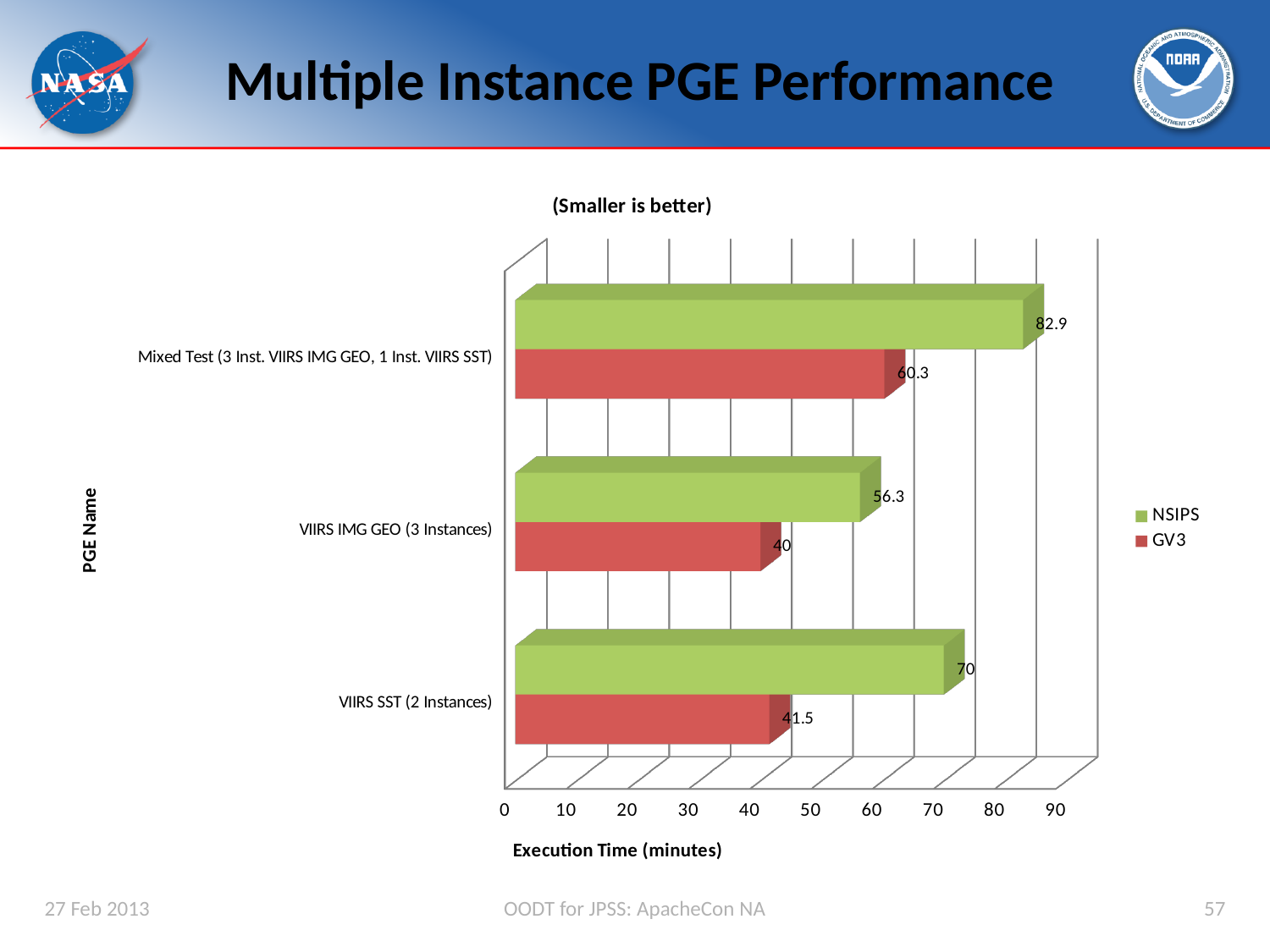
Which is larger for the Mixed Test: the NSIPS execution time or the GV3 execution time? NSIPS What is the GV3 execution time for VIIRS IMG GEO (3 Instances)? 40 Is the GV3 execution time for the Mixed Test greater or less than 50? greater How many PGEs are shown on the chart? 3 How many series does the legend list? 2 What is the NSIPS execution time for the Mixed Test (3 Inst. VIIRS IMG GEO, 1 Inst. VIIRS SST)? 82.9 What kind of chart is shown on the slide? Bar chart Which PGE has the lowest GV3 execution time? VIIRS IMG GEO (3 Instances) What is the difference between the NSIPS and GV3 execution times for VIIRS SST (2 Instances)? 28.5 What is the GV3 execution time for VIIRS SST (2 Instances)? 41.5 Which PGE has the highest NSIPS execution time? Mixed Test (3 Inst. VIIRS IMG GEO, 1 Inst. VIIRS SST) What is the NSIPS execution time for VIIRS IMG GEO (3 Instances)? 56.3